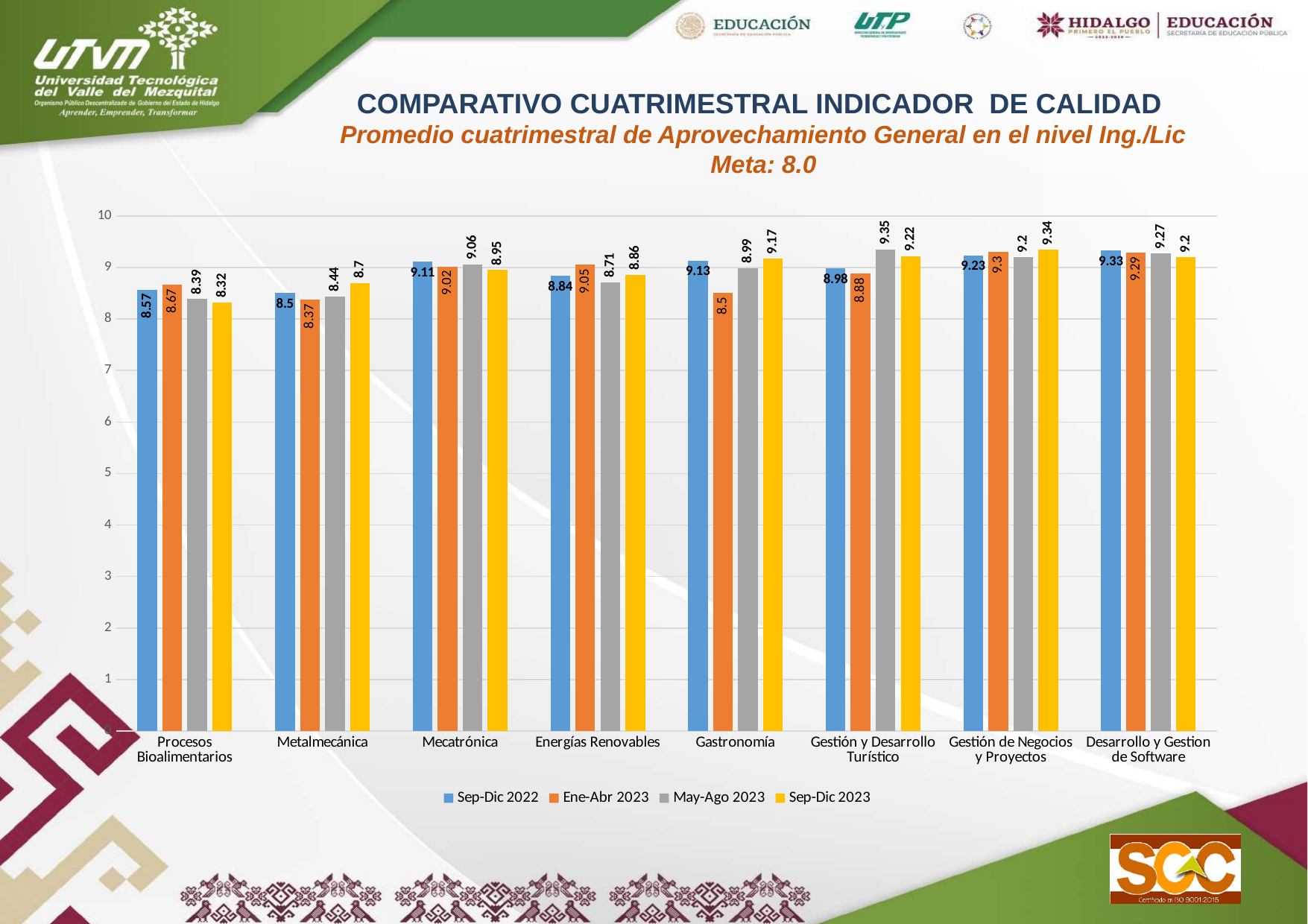
What type of chart is shown on the slide? Bar chart What target (Meta) is stated in the chart title? 8.0 Which category has the lowest value in the Sep-Dic 2023 series? Procesos Bioalimentarios How many program categories are shown on the x axis? 8 What is the value for Desarrollo y Gestion de Software in the Sep-Dic 2022 series? 9.33 What is the value for Mecatrónica in the May-Ago 2023 series? 9.06 Which category has the highest value in the May-Ago 2023 series? Gestión y Desarrollo Turístico What is the difference between the Sep-Dic 2023 and Ene-Abr 2023 values for Gastronomía? 0.67 What is the value for Gastronomía in the Ene-Abr 2023 series? 8.5 Which category has the highest value in the Sep-Dic 2023 series? Gestión de Negocios y Proyectos For Mecatrónica, which is larger: the Sep-Dic 2022 value or the Sep-Dic 2023 value? Sep-Dic 2022 How many series does the legend list? 4